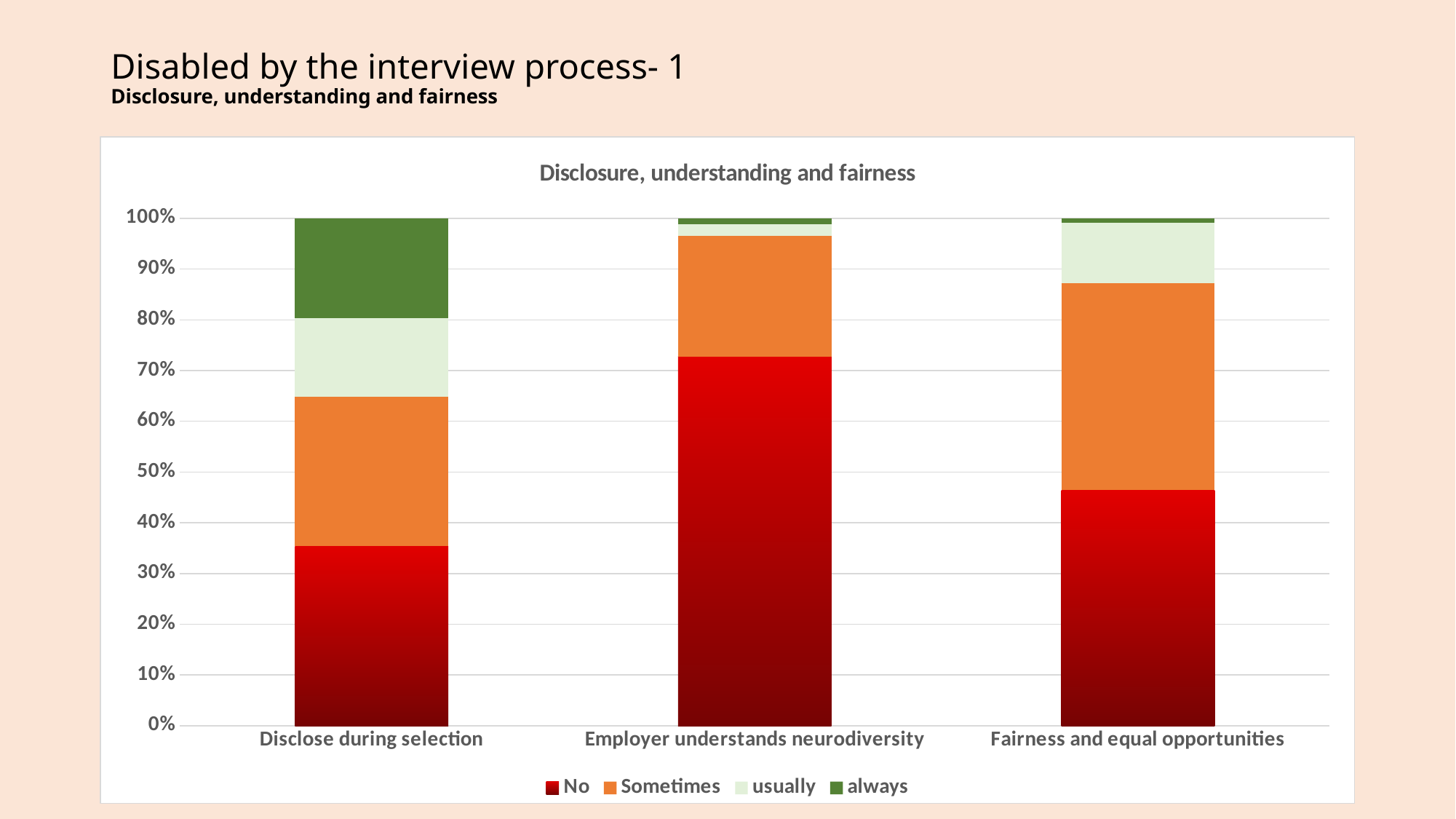
How many series does the chart legend list? 4 What kind of chart is shown on the slide? Stacked bar chart Which category has the largest 'No' segment? Employer understands neurodiversity What is the title of the chart? Disclosure, understanding and fairness Which category has the largest 'always' segment? Disclose during selection Is the 'No' value for Disclose during selection greater or less than 40%? less Which series is shown in dark green in the chart? always Which category has the smallest 'No' segment? Disclose during selection Is the 'No' segment larger for Fairness and equal opportunities or for Disclose during selection? Fairness and equal opportunities How many categories are shown on the x axis of the chart? 3 What is the total height of the stacked bar for Disclose during selection? 100% Is the 'No' value for Employer understands neurodiversity greater or less than 70%? greater